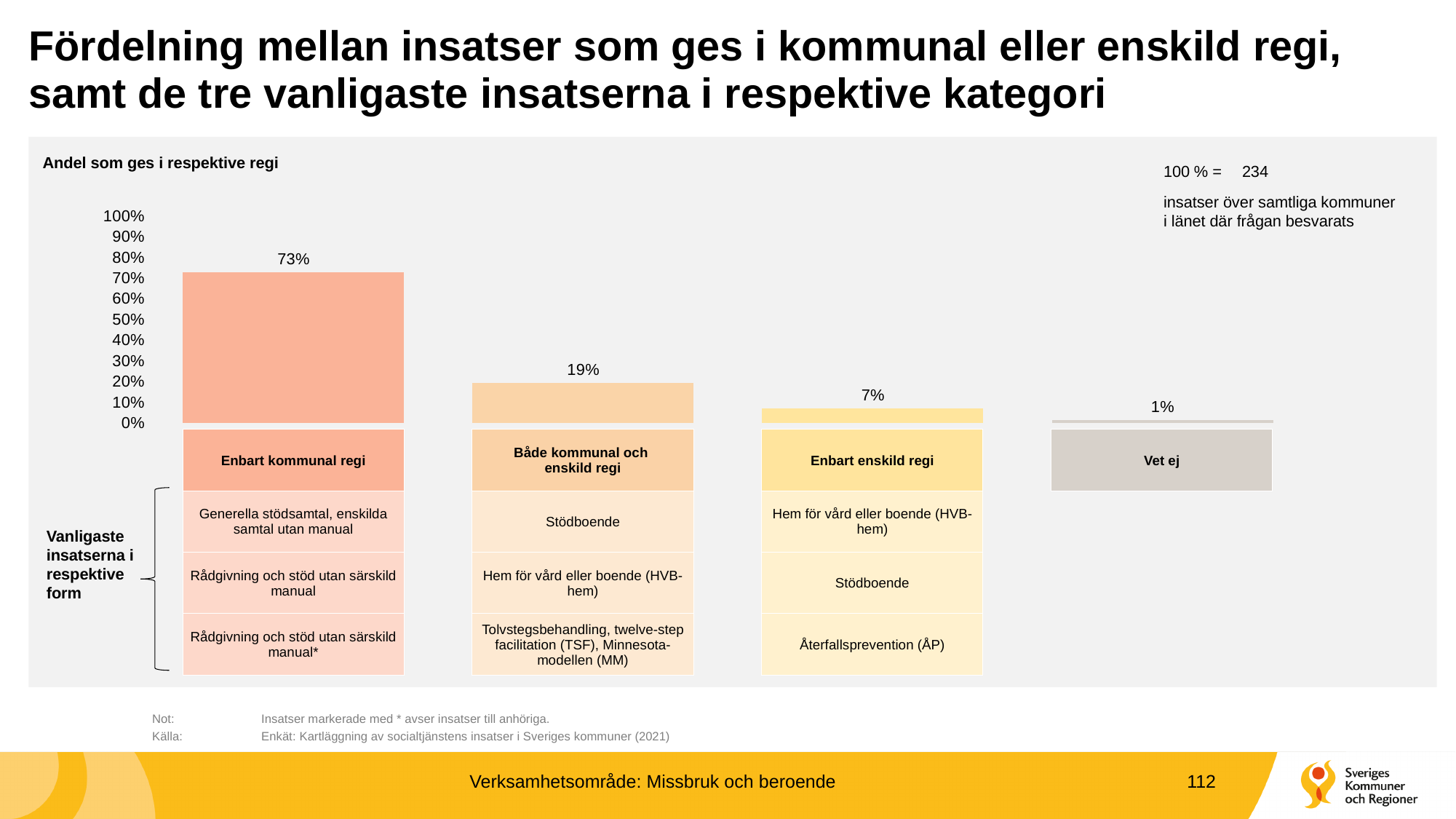
What number does 100 % correspond to according to the note on the right of the chart? 234 Which is larger, Enbart enskild regi or Vet ej? Enbart enskild regi What is the value for Både kommunal och enskild regi? 19% What is the difference between Enbart kommunal regi and Både kommunal och enskild regi? 54% What is the value for Enbart kommunal regi? 73% What is the value for Vet ej? 1% What kind of chart is this? bar chart What is the value for Enbart enskild regi? 7% Which category has the lowest value? Vet ej How many categories are shown in the chart? 4 Is the value for Enbart kommunal regi greater or less than 50%? greater Which category has the highest value? Enbart kommunal regi